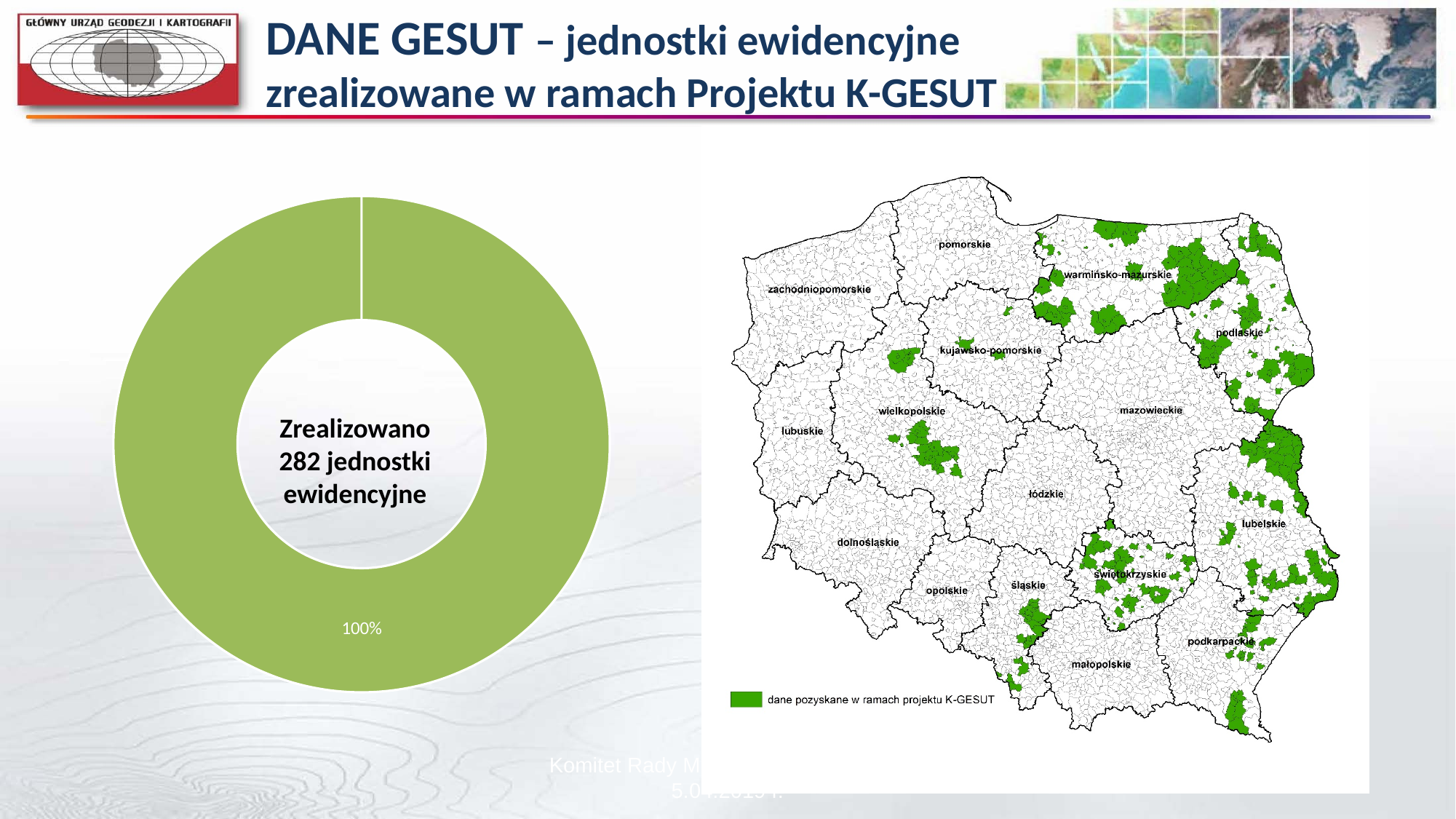
What share of the doughnut chart does the single slice occupy? 100% What percentage label is printed on the doughnut chart? 100% According to the text in the centre of the doughnut chart, how many 'jednostki ewidencyjne' were completed (zrealizowano)? 282 What text is written in the centre of the doughnut chart? Zrealizowano 282 jednostki ewidencyjne What colour is the slice of the doughnut chart? green How many slices does the doughnut chart contain? 1 What kind of chart is shown on the left side of the slide? doughnut chart